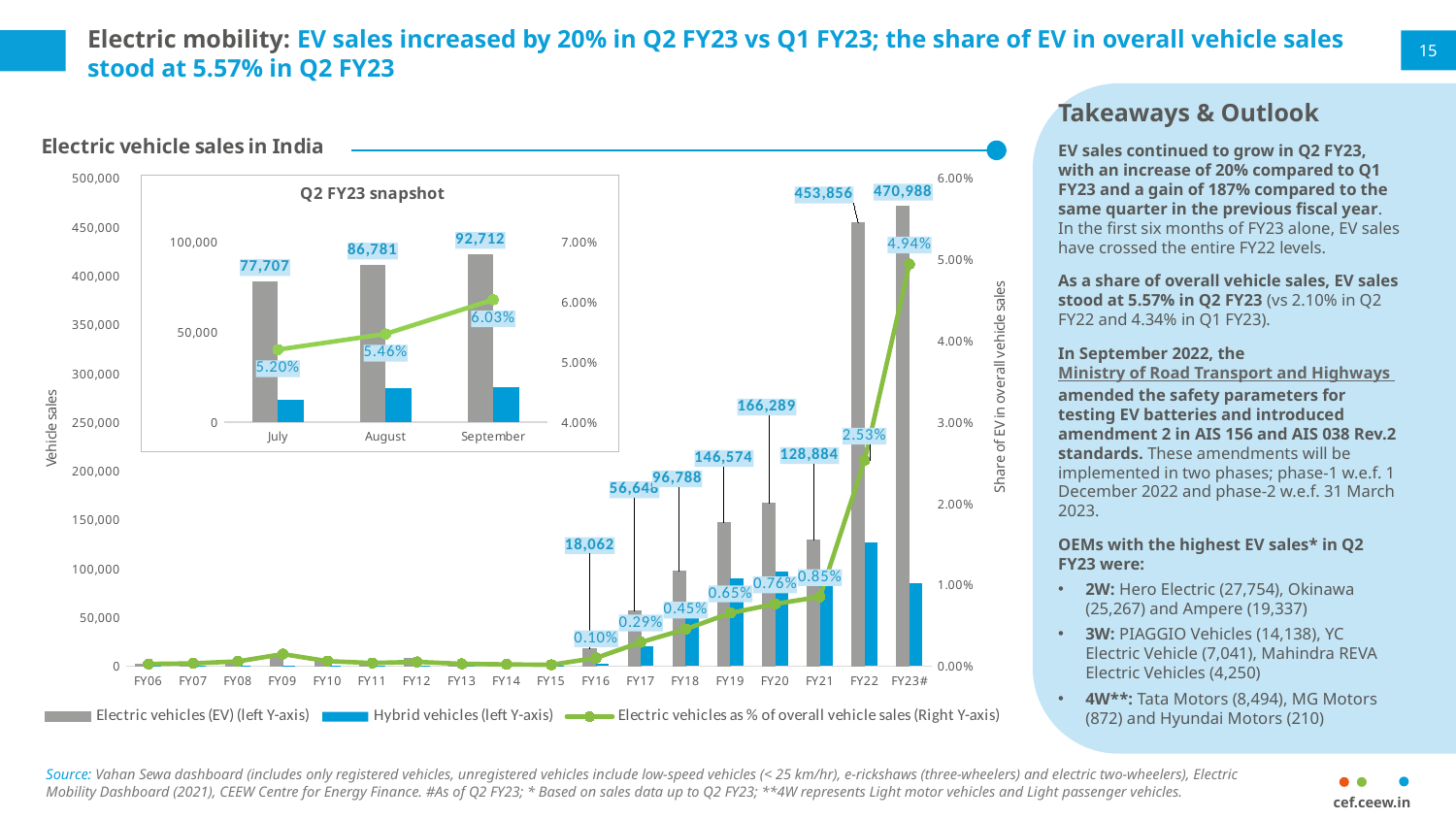
In the 'Electric vehicle sales in India' chart, which is larger: electric vehicle sales in FY20 or in FY21? FY20 In the 'Q2 FY23 snapshot' chart, what is the electric vehicle sales value labelled for August? 86,781 In the 'Electric vehicle sales in India' chart, what is the electric vehicle sales value labelled for FY22? 453,856 In the 'Electric vehicle sales in India' chart, how many fiscal years are shown on the x axis? 18 In the 'Electric vehicle sales in India' chart, which fiscal year has the highest labelled electric vehicle sales? FY23# In the 'Q2 FY23 snapshot' chart, what is the difference between the electric vehicle sales labelled for September and July? 15,005 In the 'Electric vehicle sales in India' chart, how many series does the legend list? 3 In the 'Electric vehicle sales in India' chart, what share of overall vehicle sales did electric vehicles have in FY23#? 4.94% In the 'Q2 FY23 snapshot' chart, do electric vehicle sales rise or fall from July to September? rise In the 'Electric vehicle sales in India' chart, what is the electric vehicle sales value labelled for FY19? 146,574 In the 'Electric vehicle sales in India' chart, what is the difference between the electric vehicle sales labelled for FY23# and FY22? 17,132 In the 'Q2 FY23 snapshot' chart, what share of overall vehicle sales did electric vehicles have in September? 6.03%